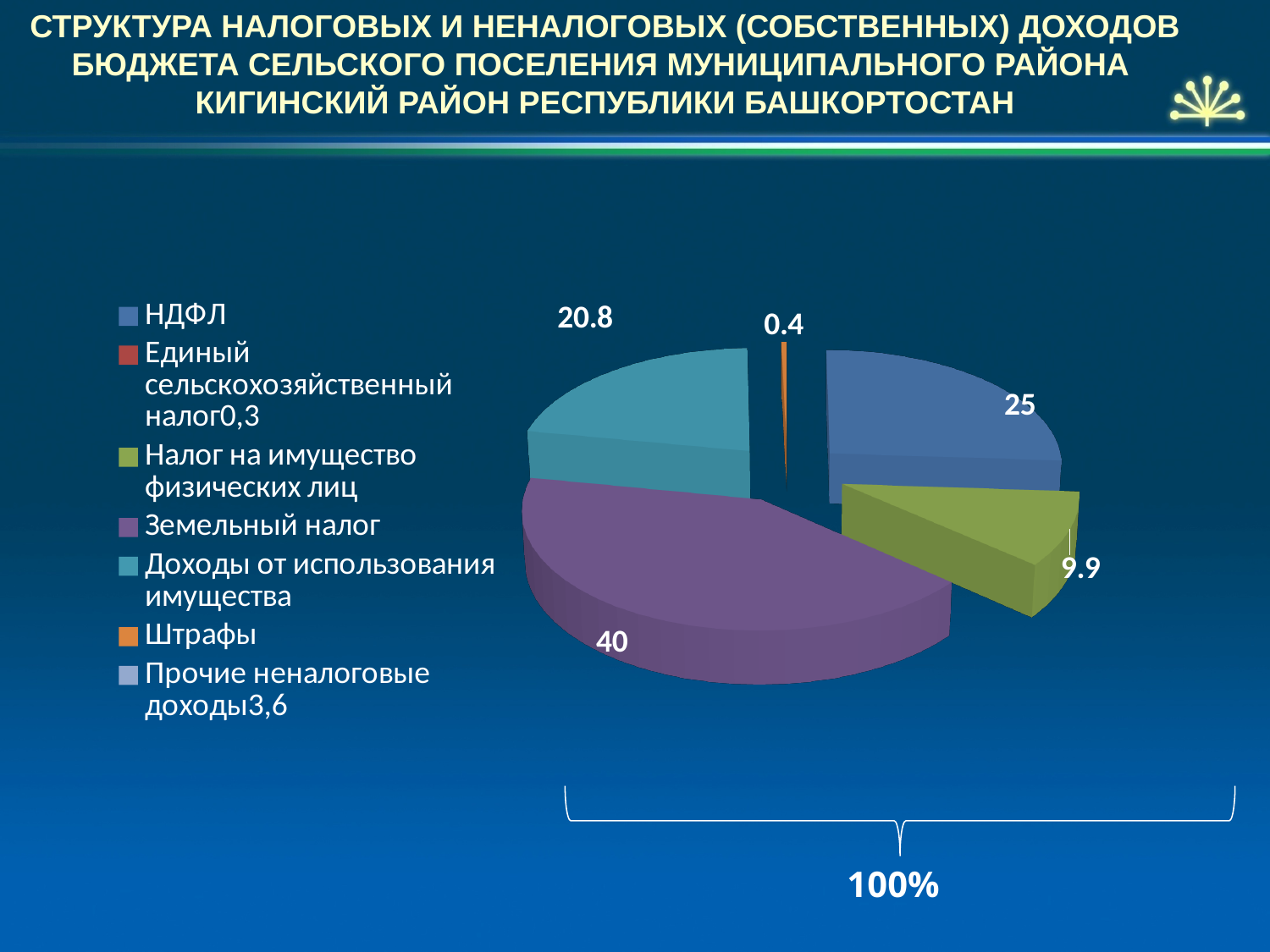
What value is shown for Земельный налог on the pie chart? 40 What value is shown for Штрафы on the pie chart? 0.4 Which category has the largest slice of the pie chart? Земельный налог What is the difference between the values for Земельный налог and Доходы от использования имущества? 19.2 What value is shown for Доходы от использования имущества? 20.8 What is the difference between the values for Земельный налог and НДФЛ? 15 What colour is the Земельный налог slice in the pie chart? Purple How many categories does the legend of the pie chart list? 7 What kind of chart is shown on the slide? Pie chart Which is larger, the value for НДФЛ or the value for Доходы от использования имущества? НДФЛ What value is shown for Налог на имущество физических лиц? 9.9 What value is shown for НДФЛ on the pie chart? 25